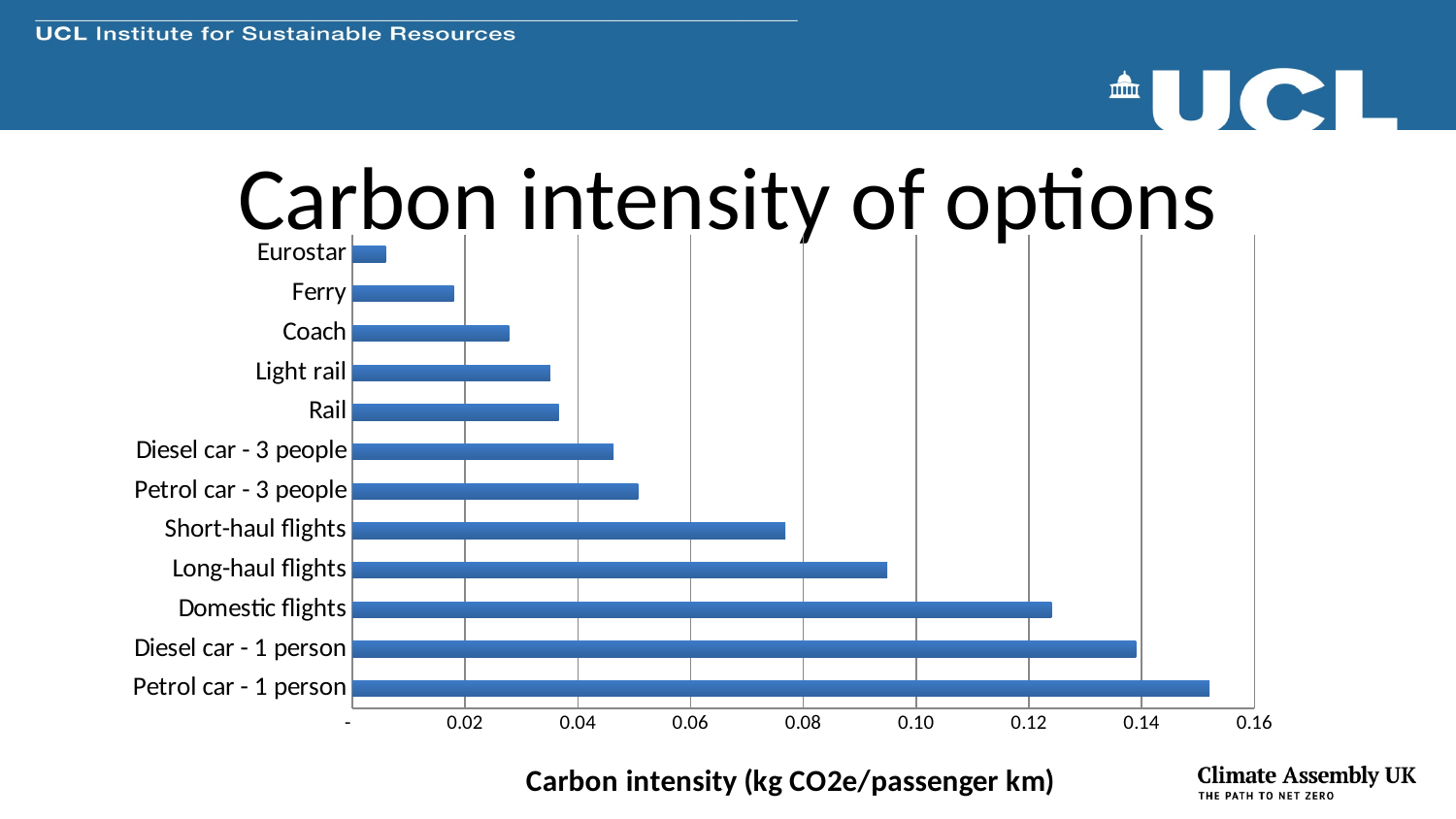
Which has the larger carbon intensity, Coach or Short-haul flights? Short-haul flights Which travel option has the lowest carbon intensity in the chart? Eurostar Which travel option has the highest carbon intensity in the chart? Petrol car - 1 person Is the value for Rail greater or less than 0.04? less Is the value for Petrol car - 1 person greater or less than 0.14? greater What kind of chart is shown on the slide? bar chart What is the label on the horizontal axis of the chart? Carbon intensity (kg CO2e/passenger km) Is the value for Domestic flights greater or less than 0.10? greater Which has the larger carbon intensity, Domestic flights or Long-haul flights? Domestic flights How many categories (travel options) are plotted in the chart? 12